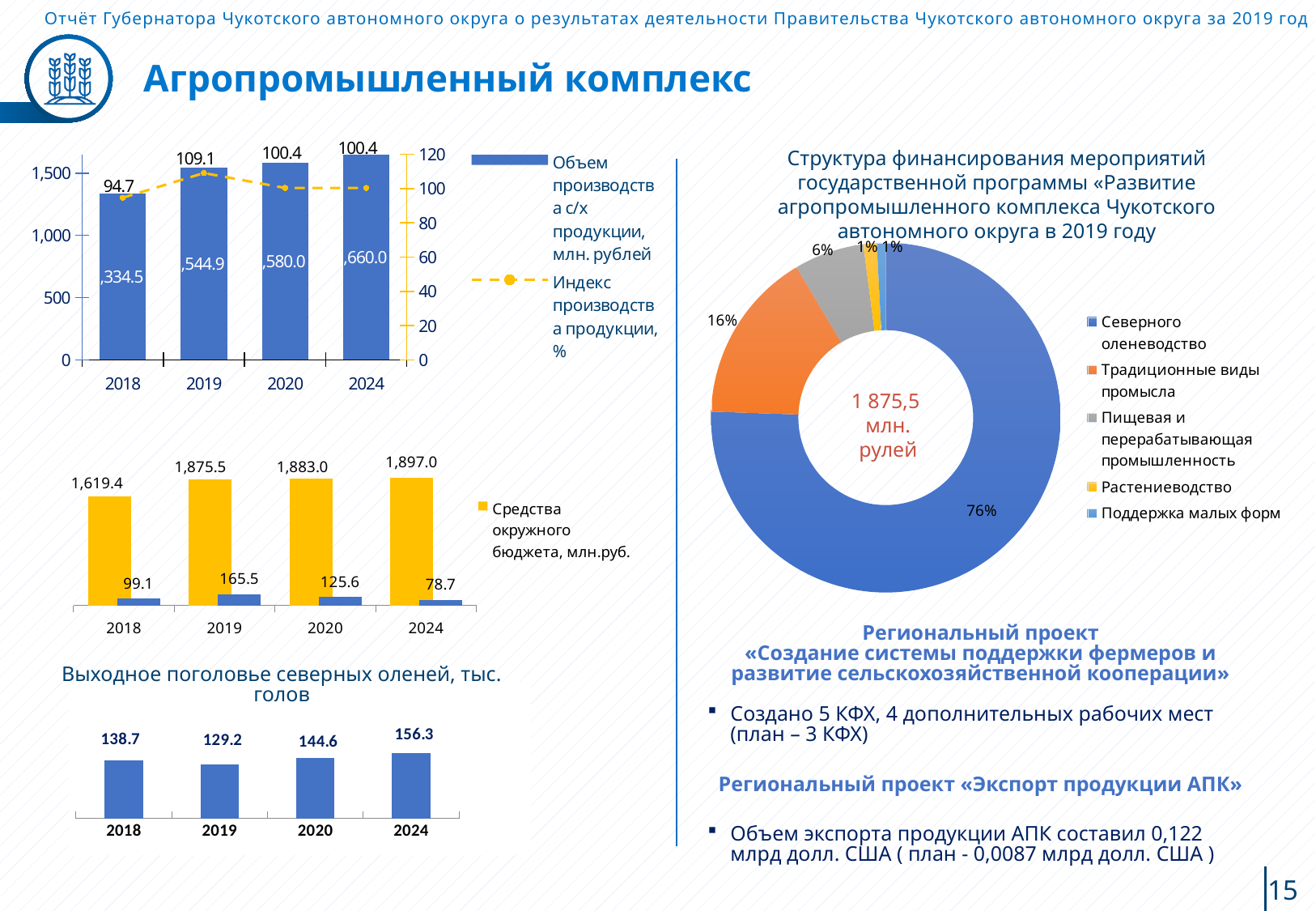
In the chart 'Выходное поголовье северных оленей, тыс. голов', what is the value for 2024? 156.3 In the chart 'Выходное поголовье северных оленей, тыс. голов', what is the difference between the 2024 and 2018 values? 17.6 In the top-left chart, what is the value of 'Индекс производства продукции, %' for 2018? 94.7 In the middle-left chart with the legend 'Средства окружного бюджета, млн.руб.', what is the value of the yellow bar for 2018? 1,619.4 In the middle-left chart with the legend 'Средства окружного бюджета, млн.руб.', is the blue bar for 2019 larger or smaller than the blue bar for 2024? larger In the top-left chart, in which year is 'Индекс производства продукции, %' highest? 2019 In the top-left chart, is the bar for 'Объем производства с/х продукции, млн. рублей' in 2024 greater or less than 1,500? greater In the middle-left chart with the legend 'Средства окружного бюджета, млн.руб.', which year has the highest yellow bar? 2024 In the chart 'Выходное поголовье северных оленей, тыс. голов', which year has the lowest value? 2019 In the donut chart 'Структура финансирования мероприятий государственной программы...', what share does 'Традиционные виды промысла' have? 16% In the chart 'Выходное поголовье северных оленей, тыс. голов', how many years are shown on the x axis? 4 In the donut chart 'Структура финансирования мероприятий государственной программы...', how many categories does the legend list? 5